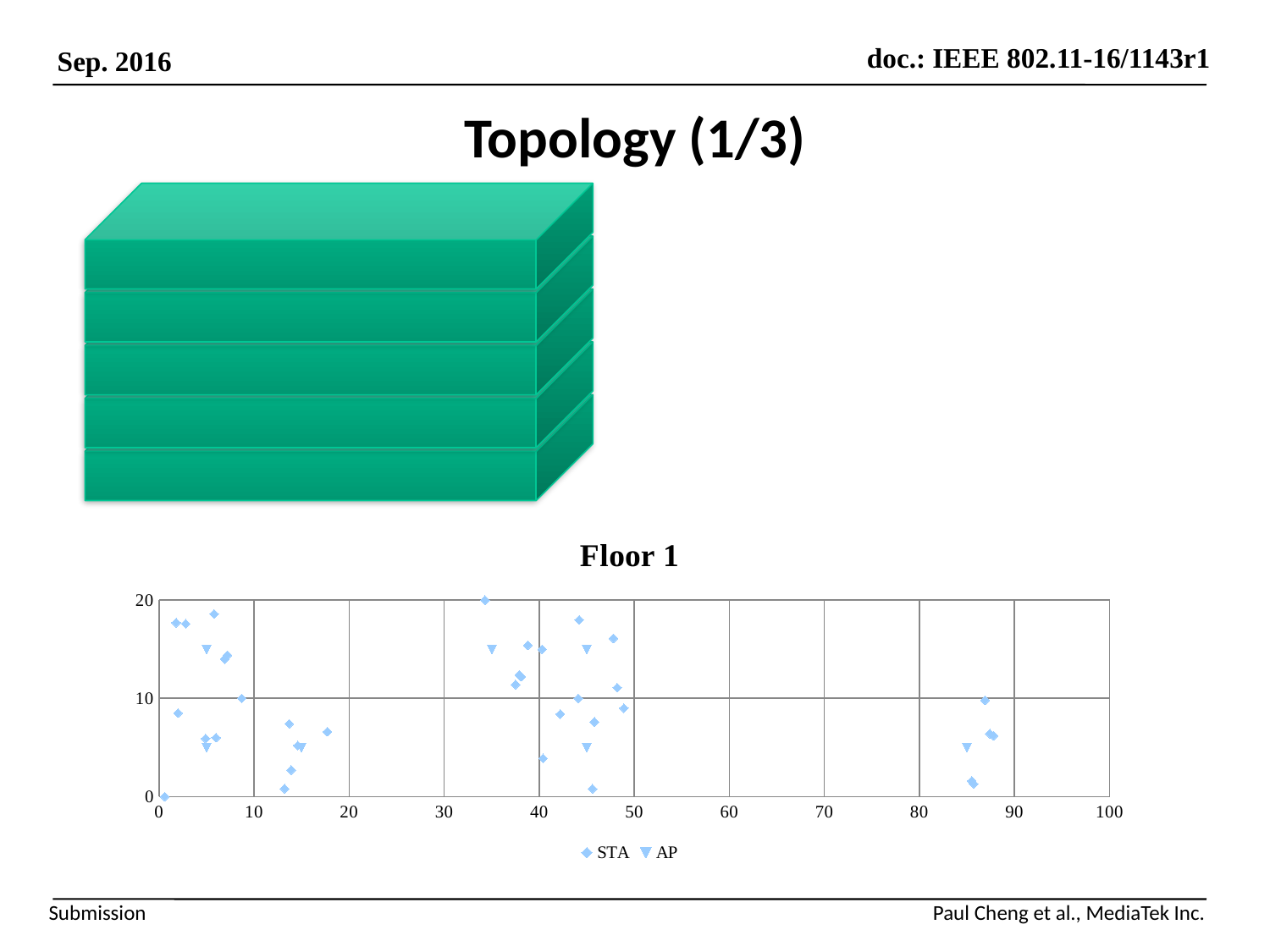
How many series does the chart's legend list? 2 Is the y value of the highest STA point greater or less than 10? greater How many AP points (triangles) are plotted on the chart? 7 What kind of chart is shown on the slide? scatter chart What is the maximum value shown on the chart's y axis? 20 Are there any points plotted between x = 60 and x = 80 on the chart? No What is the title of the chart? Floor 1 What are the two series named in the chart's legend? STA and AP What is the maximum value shown on the chart's x axis? 100